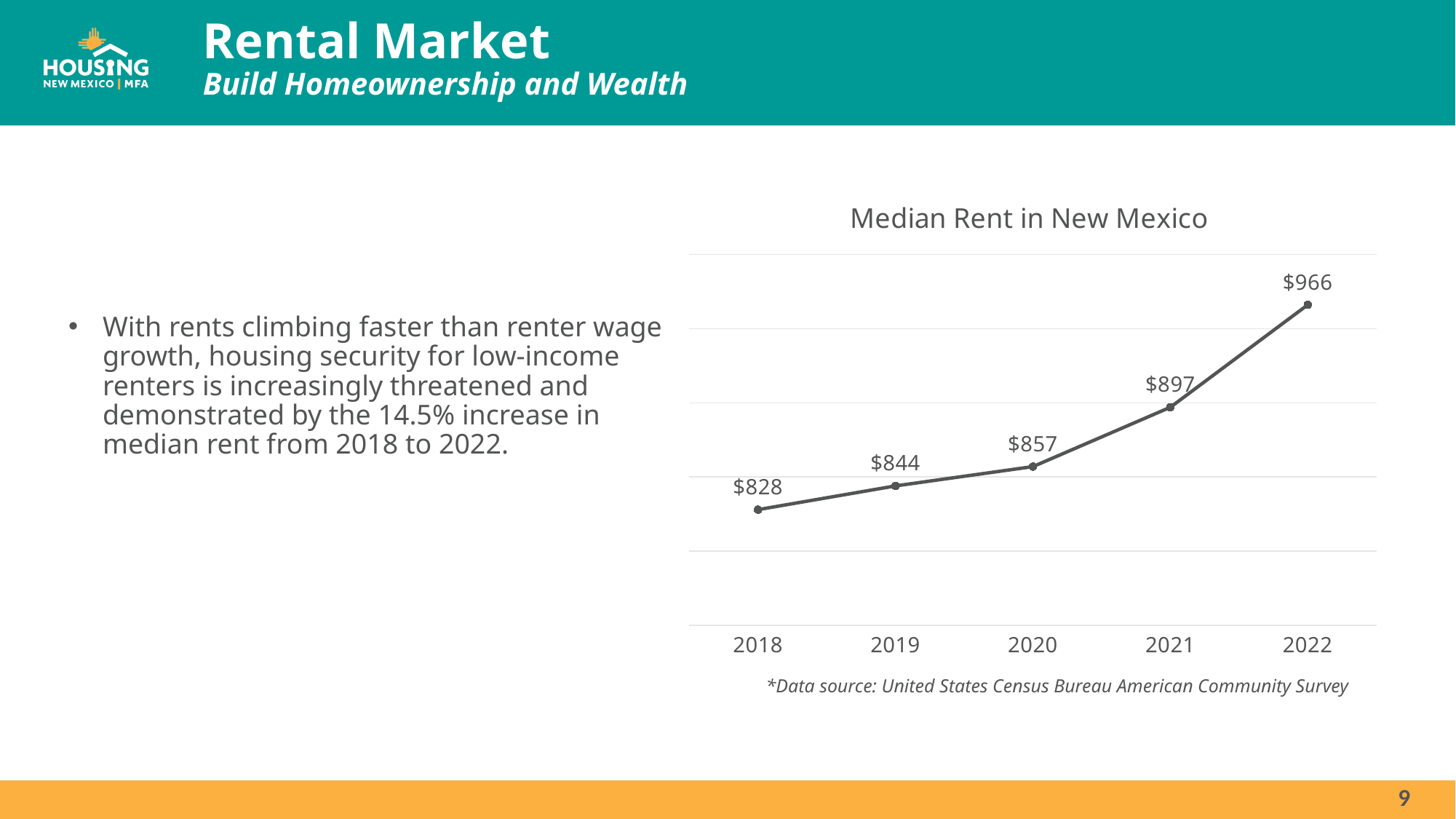
What kind of chart is shown on the slide? Line chart What is the title of the chart? Median Rent in New Mexico How many years are plotted on the chart? 5 What is the median rent in New Mexico for 2022? $966 Which year has the lowest median rent? 2018 Does the median rent rise or fall from 2018 to 2022? Rise Which year has a higher median rent, 2019 or 2021? 2021 What is the median rent in New Mexico for 2018? $828 What is the median rent in New Mexico for 2020? $857 Which year has the highest median rent? 2022 What is the difference in median rent between 2021 and 2020? $40 What is the difference in median rent between 2022 and 2018? $138